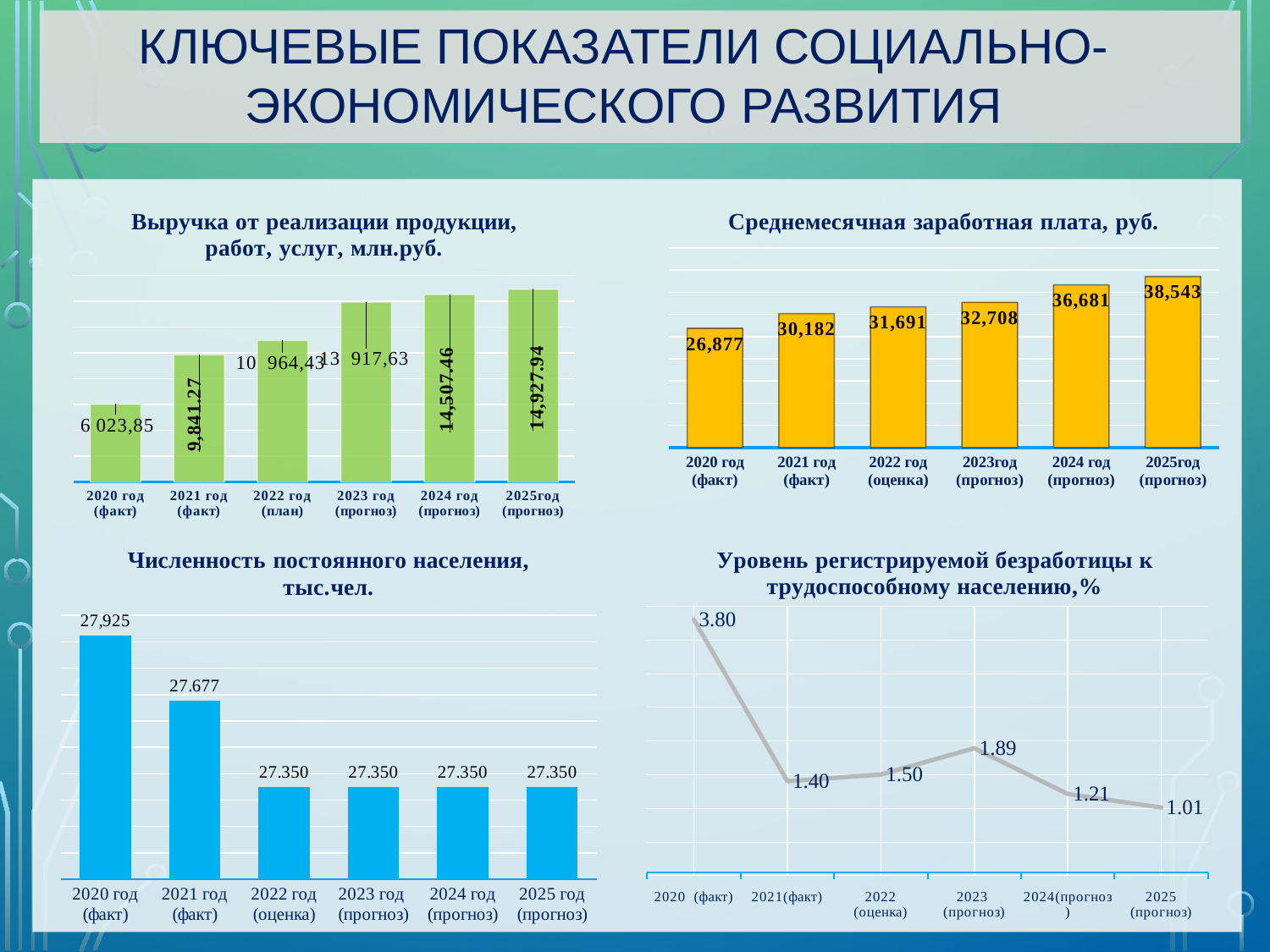
What kind of chart is 'Уровень регистрируемой безработицы к трудоспособному населению,%'? line chart In the chart 'Численность постоянного населения, тыс.чел.', which year has the highest value? 2020 год (факт) In the chart 'Уровень регистрируемой безработицы к трудоспособному населению,%', what is the value for 2023 (прогноз)? 1.89 How many bars are in the chart 'Выручка от реализации продукции, работ, услуг, млн.руб.'? 6 In the chart 'Среднемесячная заработная плата, руб.', what is the value for 2025год (прогноз)? 38,543 In the chart 'Среднемесячная заработная плата, руб.', what is the difference between the 2025год (прогноз) value and the 2020 год (факт) value? 11,666 In the chart 'Среднемесячная заработная плата, руб.', what is the value for 2020 год (факт)? 26,877 In the chart 'Выручка от реализации продукции, работ, услуг, млн.руб.', what is the value for 2024 год (прогноз)? 14,507.46 In the chart 'Уровень регистрируемой безработицы к трудоспособному населению,%', which year has the highest value? 2020 (факт) In the chart 'Уровень регистрируемой безработицы к трудоспособному населению,%', which year has the lowest value? 2025 (прогноз) In the chart 'Выручка от реализации продукции, работ, услуг, млн.руб.', do the values rise or fall from 2020 to 2025? rise In the chart 'Численность постоянного населения, тыс.чел.', what is the value for 2021 год (факт)? 27.677